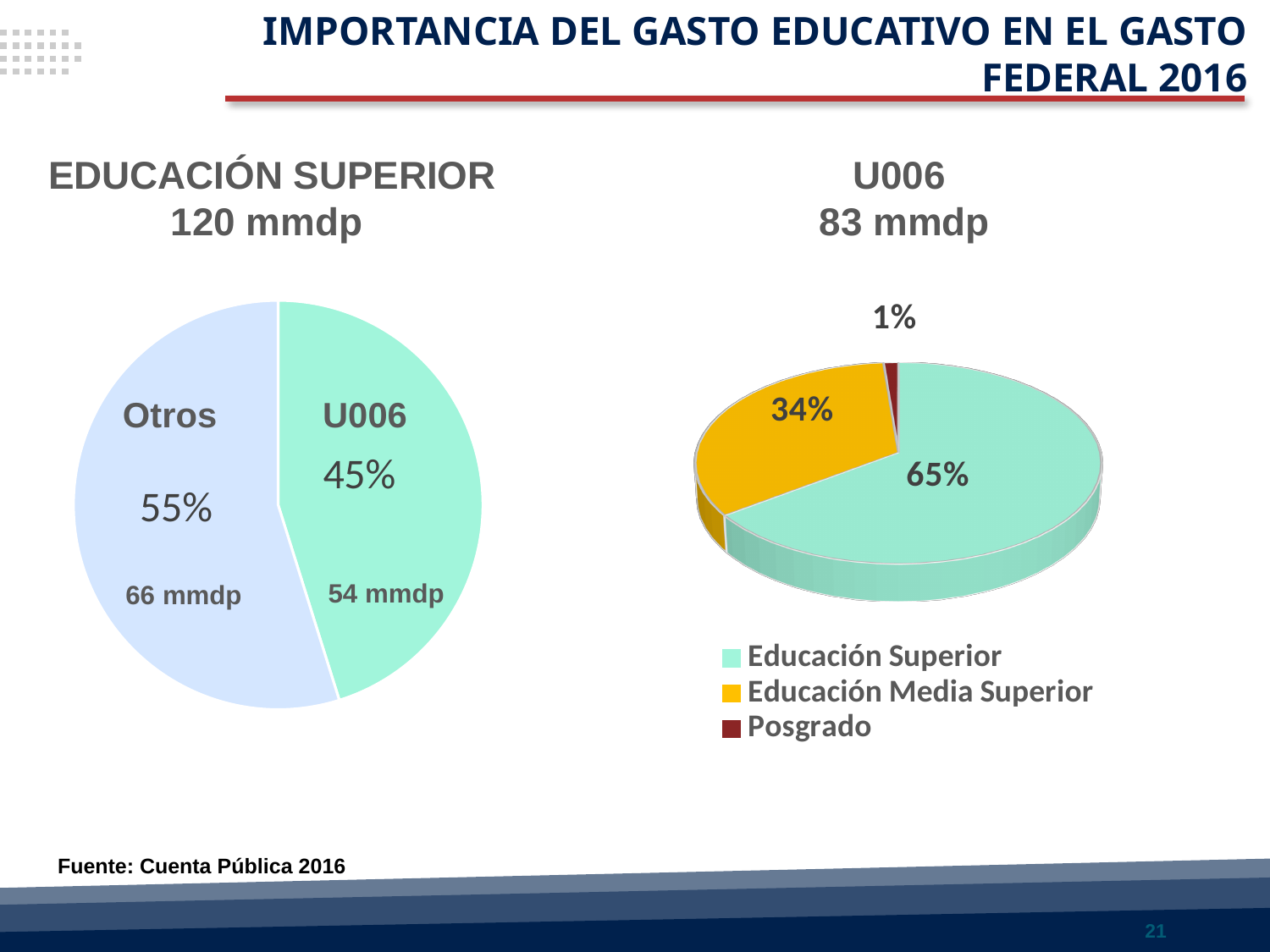
In the 'EDUCACIÓN SUPERIOR 120 mmdp' pie chart, which slice is larger, Otros or U006? Otros What type of chart is the 'U006 83 mmdp' chart on the right? Pie chart In the 'U006 83 mmdp' pie chart, what share does Posgrado represent? 1% In the 'U006 83 mmdp' pie chart, how many categories does the legend list? 3 In the 'EDUCACIÓN SUPERIOR 120 mmdp' pie chart, what share does Otros represent? 55% In the 'EDUCACIÓN SUPERIOR 120 mmdp' pie chart, what is the difference in mmdp between Otros and U006? 12 mmdp In the 'EDUCACIÓN SUPERIOR 120 mmdp' pie chart, what is the value in mmdp for U006? 54 mmdp In the 'U006 83 mmdp' pie chart, what share does Educación Superior represent? 65% In the 'EDUCACIÓN SUPERIOR 120 mmdp' pie chart, what is the value in mmdp for Otros? 66 mmdp In the 'U006 83 mmdp' pie chart, which category has the smallest slice? Posgrado